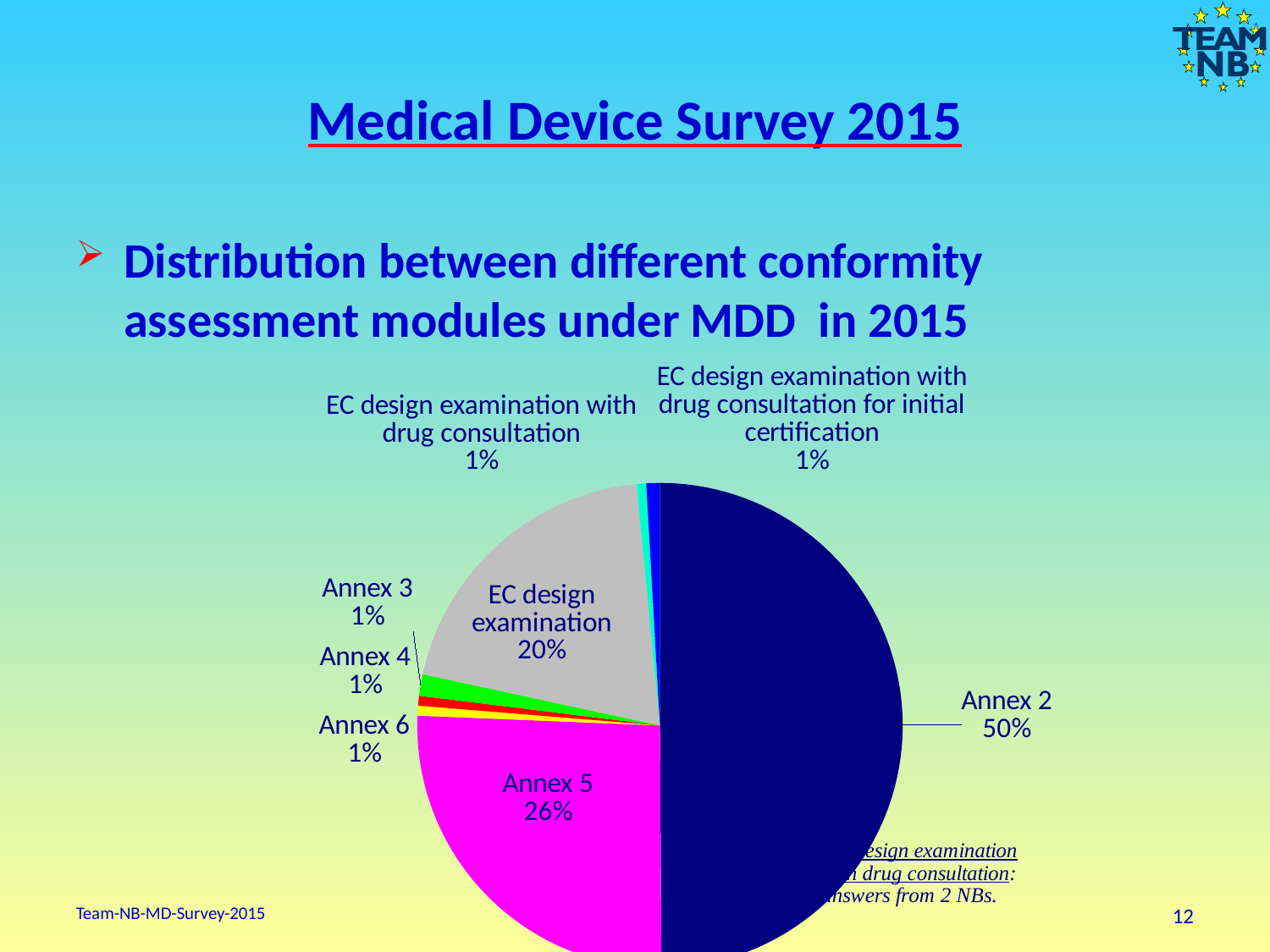
What percentage is shown for EC design examination? 20% What percentage is shown for Annex 5? 26% What is the combined share of Annex 2 and Annex 5? 76% Which is larger, the share for Annex 5 or the share for EC design examination? Annex 5 What share of the pie does Annex 2 represent? 50% How many slices does the pie chart have? 8 What colour is the Annex 5 slice? Magenta What percentage is shown for Annex 6? 1% What is the difference in percentage points between Annex 5 and EC design examination? 6 Which category has the largest slice of the pie? Annex 2 What kind of chart is shown on the slide? Pie chart What is the difference in percentage points between Annex 2 and Annex 5? 24